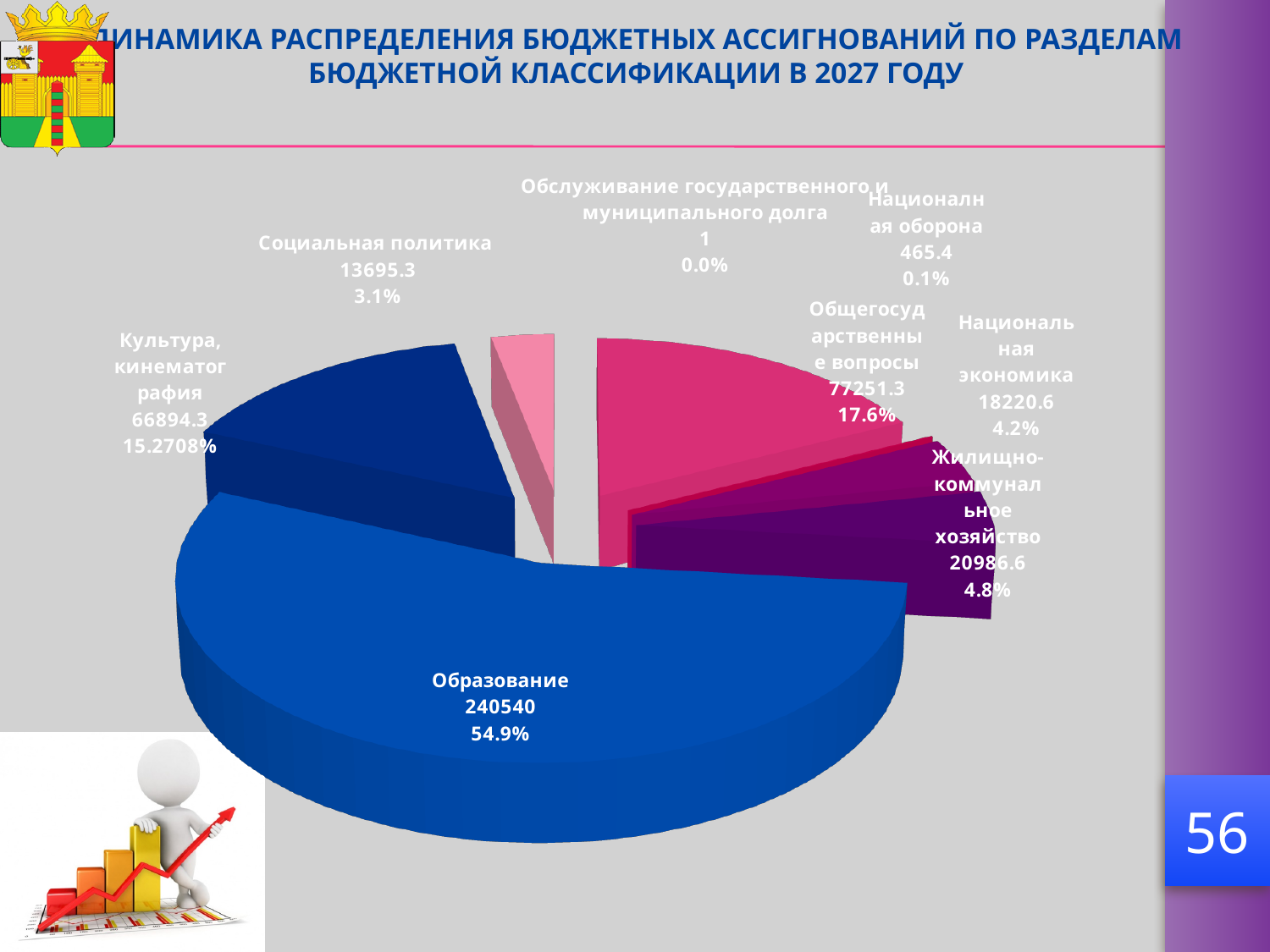
What is the difference between the values for Жилищно-коммунальное хозяйство and Национальная экономика? 2766 What is the value shown for Образование? 240540 Which category has the smallest value in the pie chart? Обслуживание государственного и муниципального долга What kind of chart is shown on the slide? Pie chart How many categories (slices) does the pie chart show? 8 What share of the pie does Образование represent? 54.9% What percentage is shown for Культура, кинематография? 15.2708% Which category has the largest share of the pie? Образование What is the value shown for Жилищно-коммунальное хозяйство? 20986.6 What is the value shown for Общегосударственные вопросы? 77251.3 Which is larger: the value for Социальная политика or the value for Национальная оборона? Социальная политика What percentage is shown for Национальная экономика? 4.2%